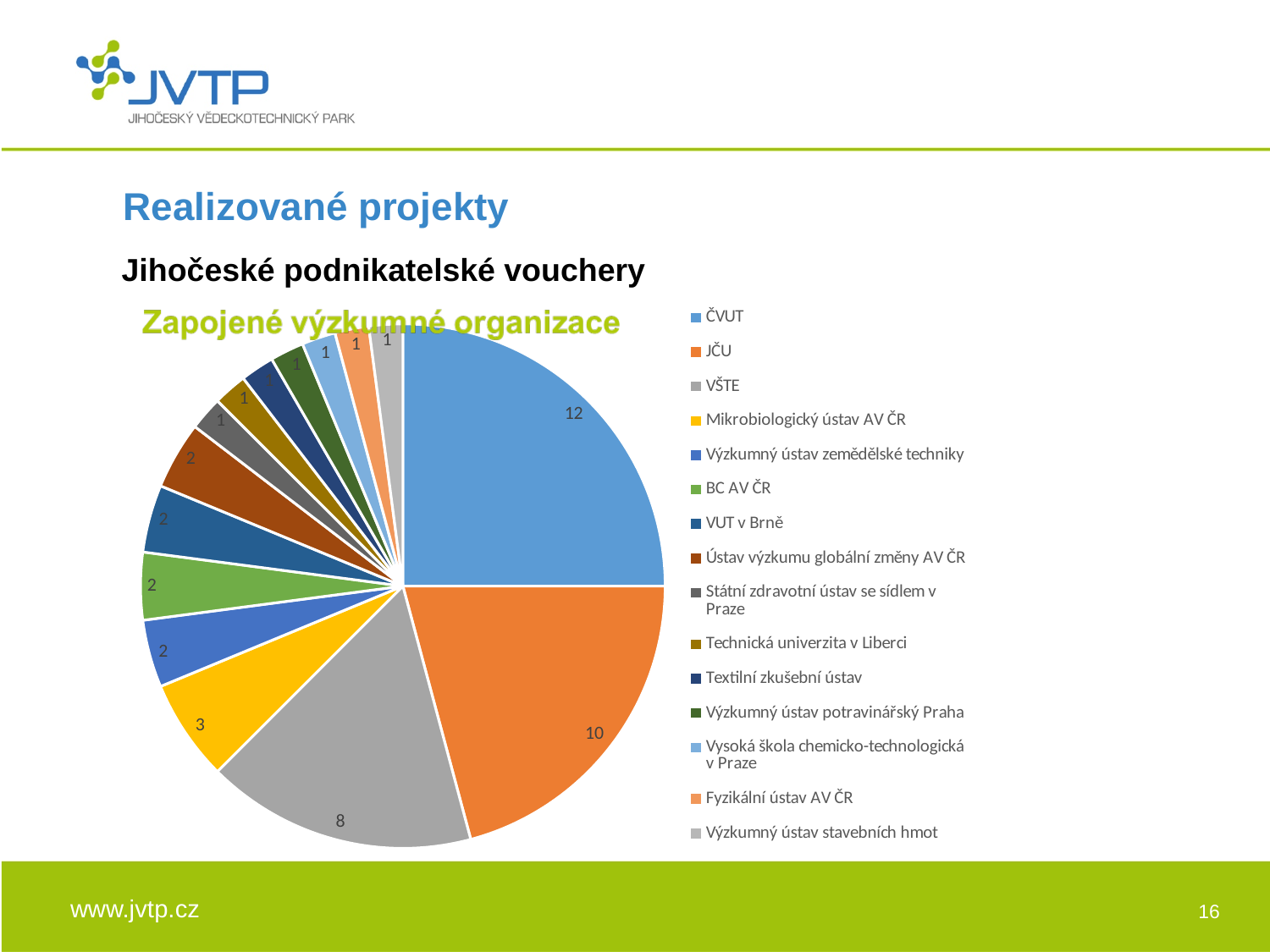
What is the value for ČVUT in the pie chart? 12 What is the value for Mikrobiologický ústav AV ČR in the pie chart? 3 How many organizations (slices) are shown in the pie chart? 15 Which organization has the largest slice in the pie chart? ČVUT Which is larger, the value for JČU or the value for VŠTE? JČU What is the difference between the values for ČVUT and VŠTE? 4 What is the value for VŠTE in the pie chart? 8 What is the title of the pie chart? Zapojené výzkumné organizace What share of the pie does ČVUT represent? 25% What kind of chart is shown on the slide? pie chart What is the value for JČU in the pie chart? 10 What is the total of all values in the pie chart? 48